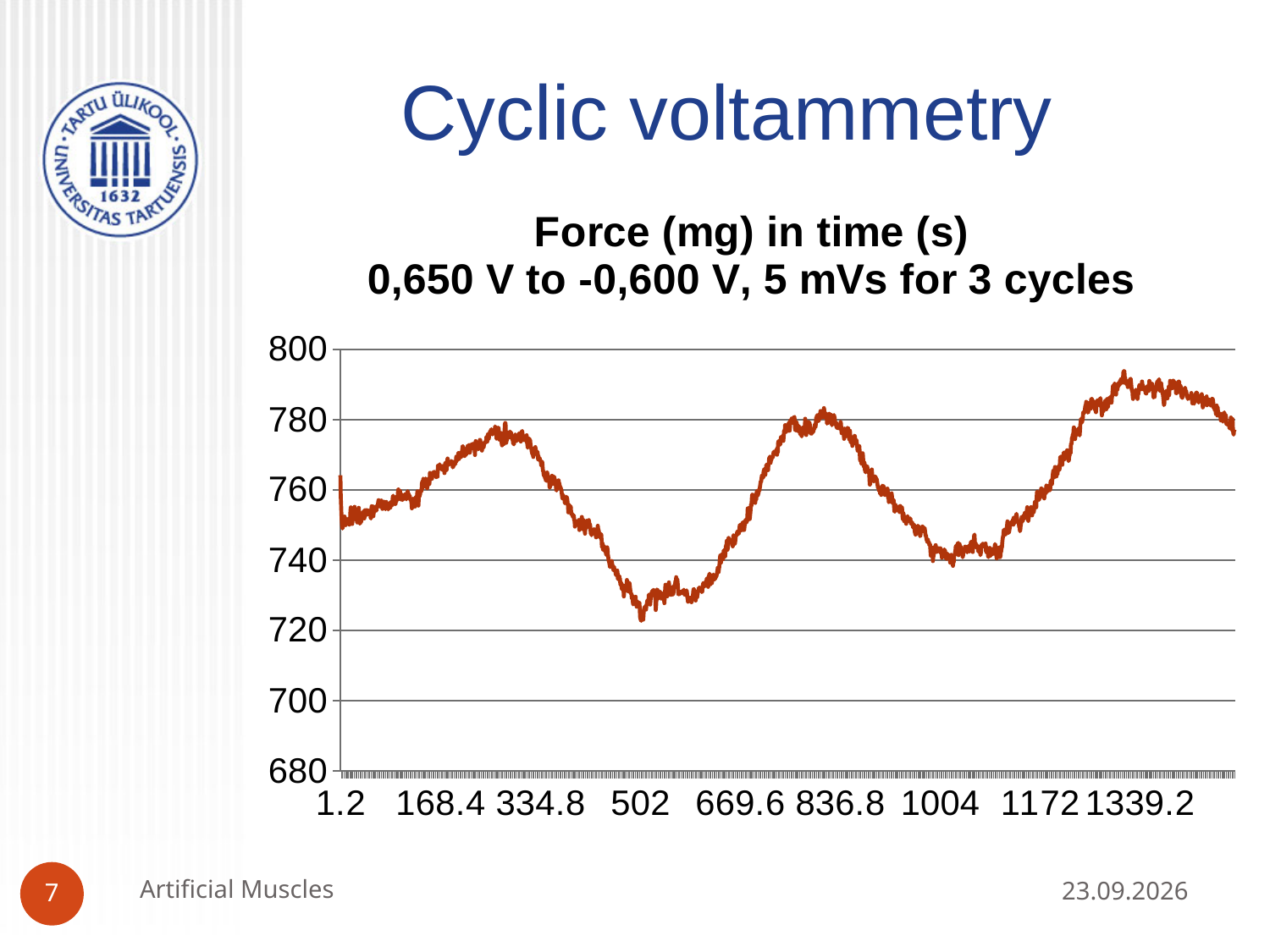
Do the successive peaks of the curve rise or fall along the x axis? rise Is the force value at time 1339.2 greater or less than 780? greater Which of the two troughs of the curve is the lowest: the first (near 502) or the second (near 1004)? the first (near 502) Which of the three peaks of the curve is the highest: the first, second or third? the third What is the highest value shown on the y axis? 800 What is the title of the chart? Force (mg) in time (s) 0,650 V to -0,600 V, 5 mVs for 3 cycles Is the force value at time 502 greater or less than 740? less Is the force value at time 1004 greater or less than 760? less How many tick labels are printed on the x axis? 9 What kind of chart is shown on the slide? line chart